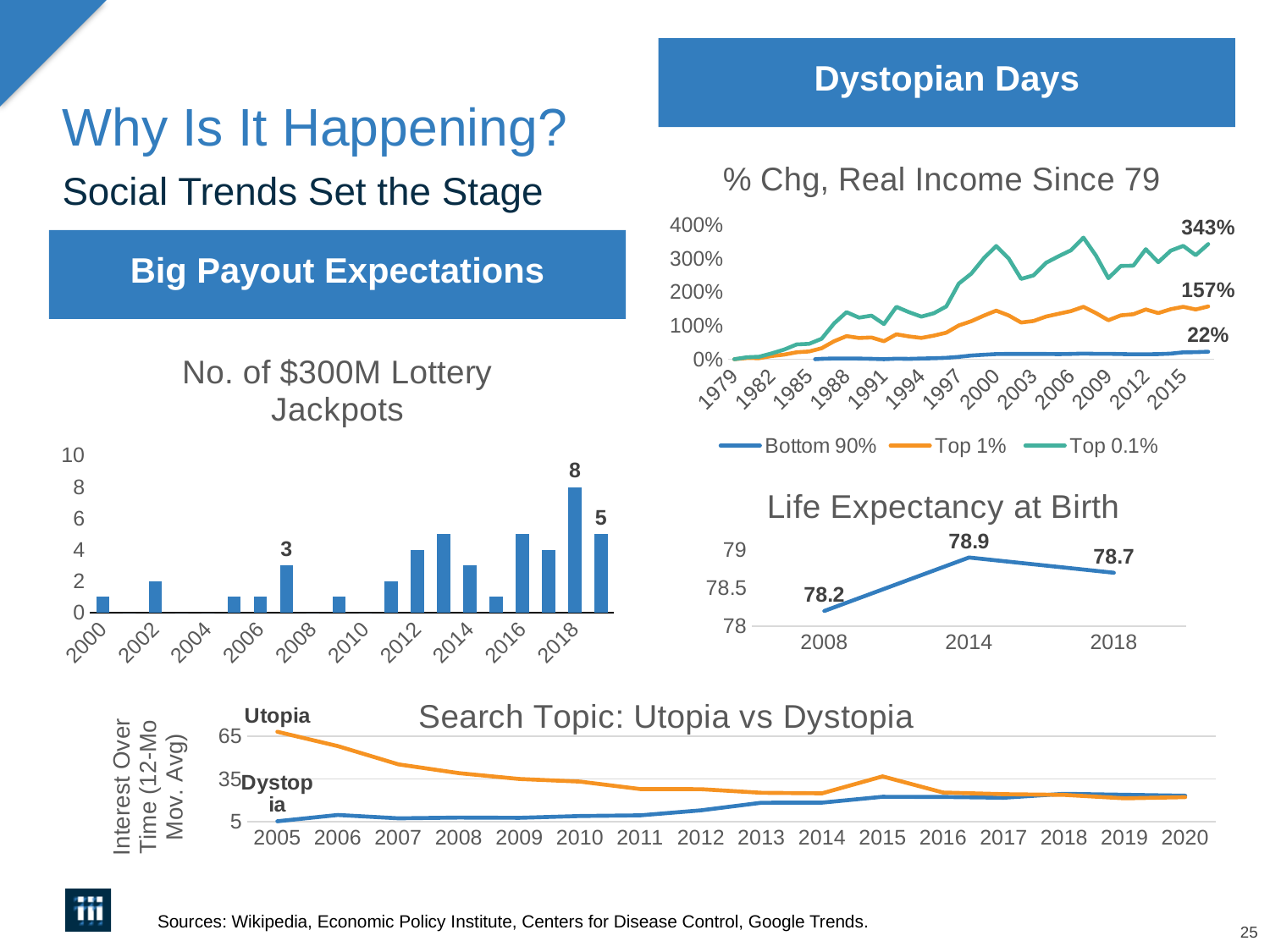
In the 'No. of $300M Lottery Jackpots' chart, what is the difference between the 2018 and 2019 values? 3 In the 'No. of $300M Lottery Jackpots' chart, how many $300M lottery jackpots were there in 2018? 8 In the '% Chg, Real Income Since 79' chart, what is the final value shown for the Top 0.1% series? 343% In the '% Chg, Real Income Since 79' chart, what is the final value shown for the Bottom 90% series? 22% In the 'Life Expectancy at Birth' chart, which year has the lowest life expectancy? 2008 In the 'Life Expectancy at Birth' chart, how many data points are plotted? 3 In the '% Chg, Real Income Since 79' chart, what is the difference between the final values of the Top 0.1% and Top 1% series? 186% How many series does the legend of the '% Chg, Real Income Since 79' chart list? 3 What kind of chart is 'No. of $300M Lottery Jackpots'? bar chart In the 'No. of $300M Lottery Jackpots' chart, which year has the highest number of jackpots? 2018 In the 'Search Topic: Utopia vs Dystopia' chart, does the Utopia series rise or fall from 2005 to 2020? fall In the 'Life Expectancy at Birth' chart, what is the value for 2014? 78.9